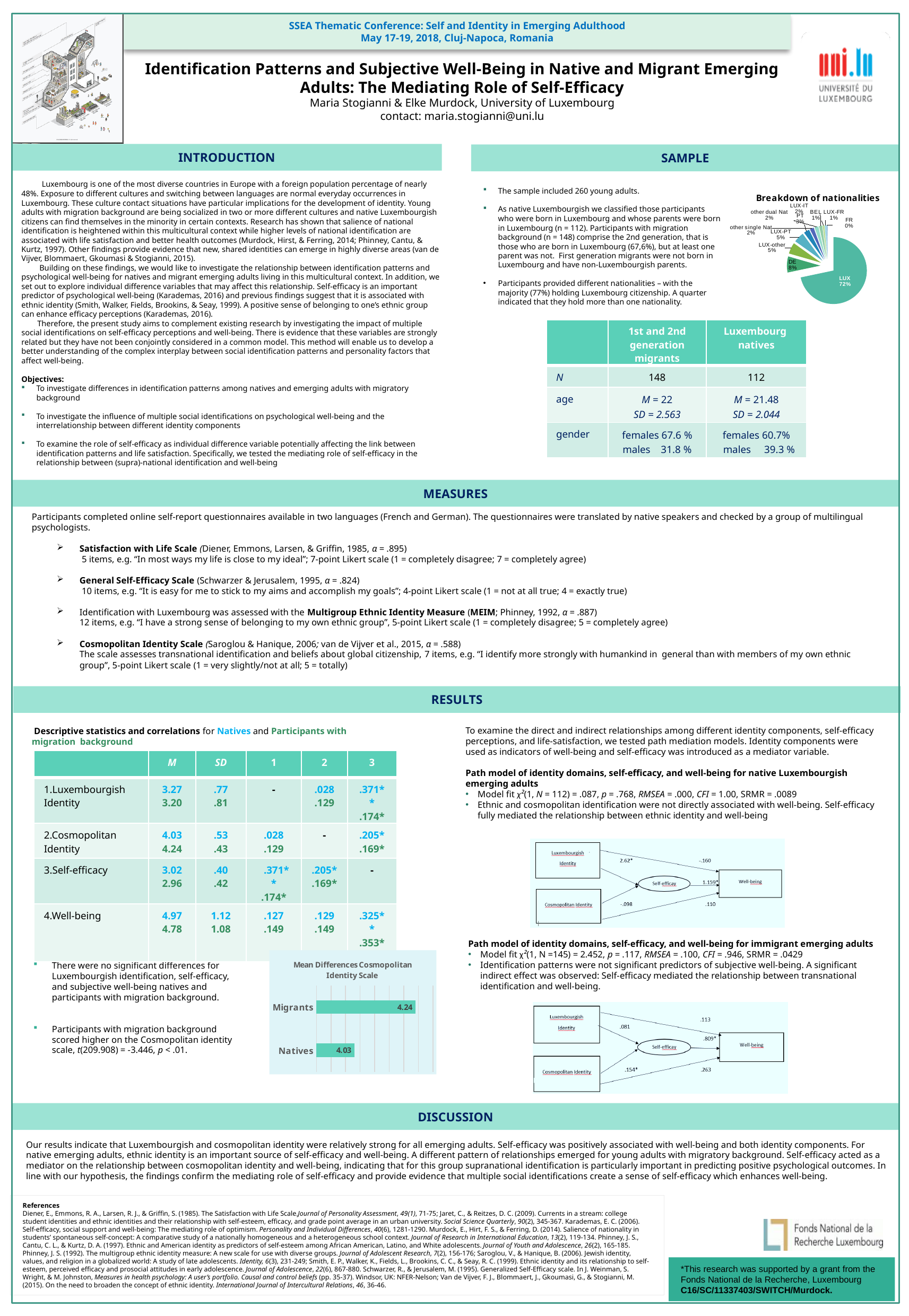
In the 'Mean Differences Cosmopolitan Identity Scale' chart, what is the value for Natives? 4.03 In the 'Mean Differences Cosmopolitan Identity Scale' chart, what is the difference between the Migrants and Natives values? 0.21 In the 'Mean Differences Cosmopolitan Identity Scale' chart, what is the value for Migrants? 4.24 In the 'Mean Differences Cosmopolitan Identity Scale' chart, which group has the lower value? Natives What kind of chart is the 'Breakdown of nationalities' chart? Pie chart In the 'Breakdown of nationalities' chart, what share is shown for FR? 0% In the 'Breakdown of nationalities' chart, what share of the sample is DE? 8% What kind of chart is the 'Mean Differences Cosmopolitan Identity Scale' chart? Bar chart In the 'Breakdown of nationalities' chart, which nationality has the largest slice? LUX In the 'Breakdown of nationalities' chart, what share of the sample is LUX? 72% In the 'Mean Differences Cosmopolitan Identity Scale' chart, which group has the higher value? Migrants In the 'Mean Differences Cosmopolitan Identity Scale' chart, how many groups are plotted? 2